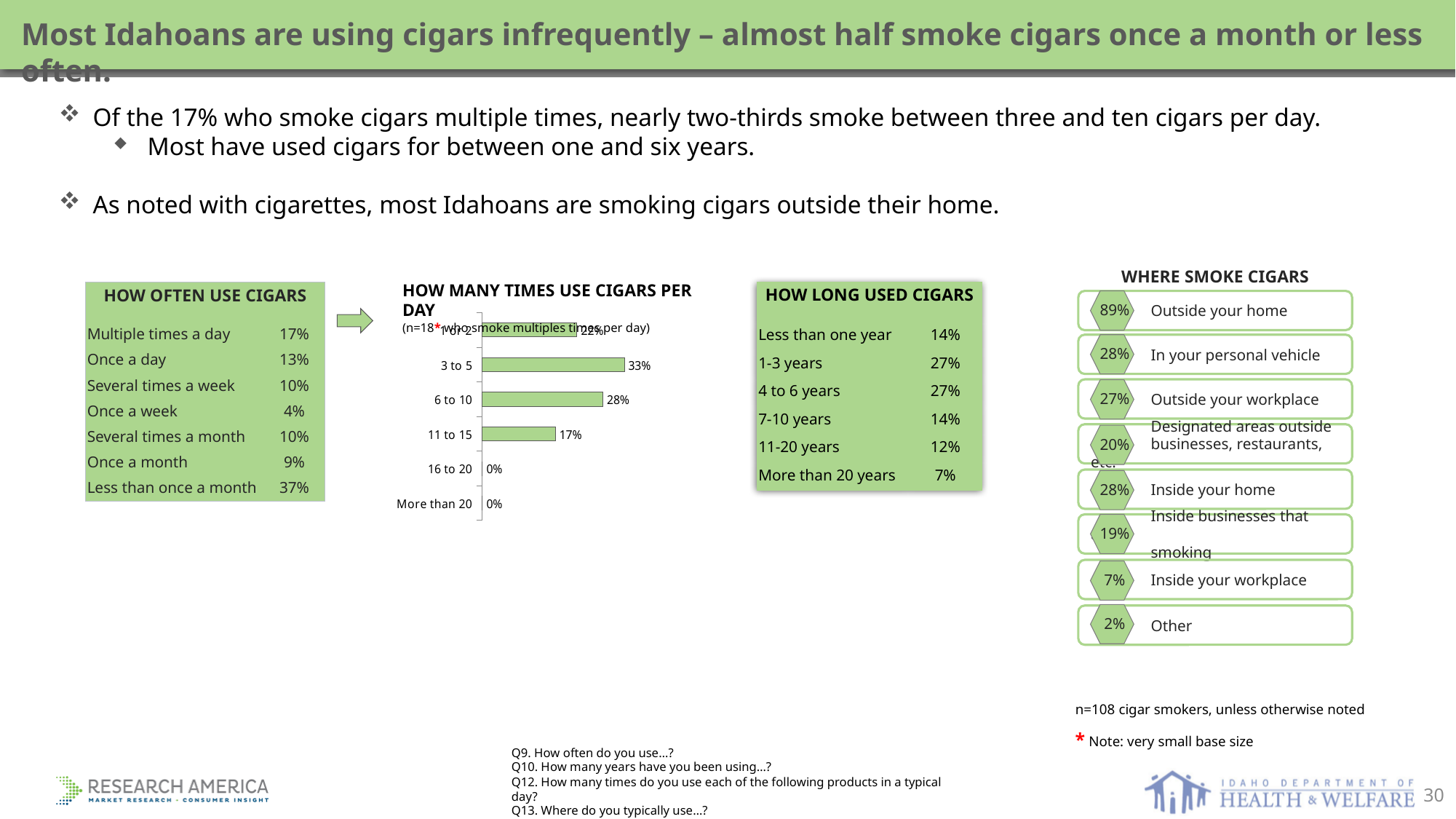
What type of chart is 'How many times use cigars per day'? Bar chart In the 'How many times use cigars per day' chart, which category has the highest value? 3 to 5 In the 'How many times use cigars per day' chart, what is the value for 16 to 20 cigars per day? 0% How many categories are shown in the 'How many times use cigars per day' chart? 6 In the 'How many times use cigars per day' chart, what is the difference between the values for 3 to 5 and 11 to 15 cigars per day? 16% In the 'How many times use cigars per day' chart, how many categories have a value of 0%? 2 What is the sample size noted under the title of the 'How many times use cigars per day' chart? n=18 In the 'How many times use cigars per day' chart, what is the value for 6 to 10 cigars per day? 28% In the 'How many times use cigars per day' chart, what is the difference between the values for 3 to 5 and 6 to 10 cigars per day? 5% In the 'How many times use cigars per day' chart, what is the value for 11 to 15 cigars per day? 17% In the 'How many times use cigars per day' chart, which is larger: the value for 6 to 10 or the value for 1 or 2 cigars per day? 6 to 10 In the 'How many times use cigars per day' chart, what percentage of respondents use 3 to 5 cigars per day? 33%